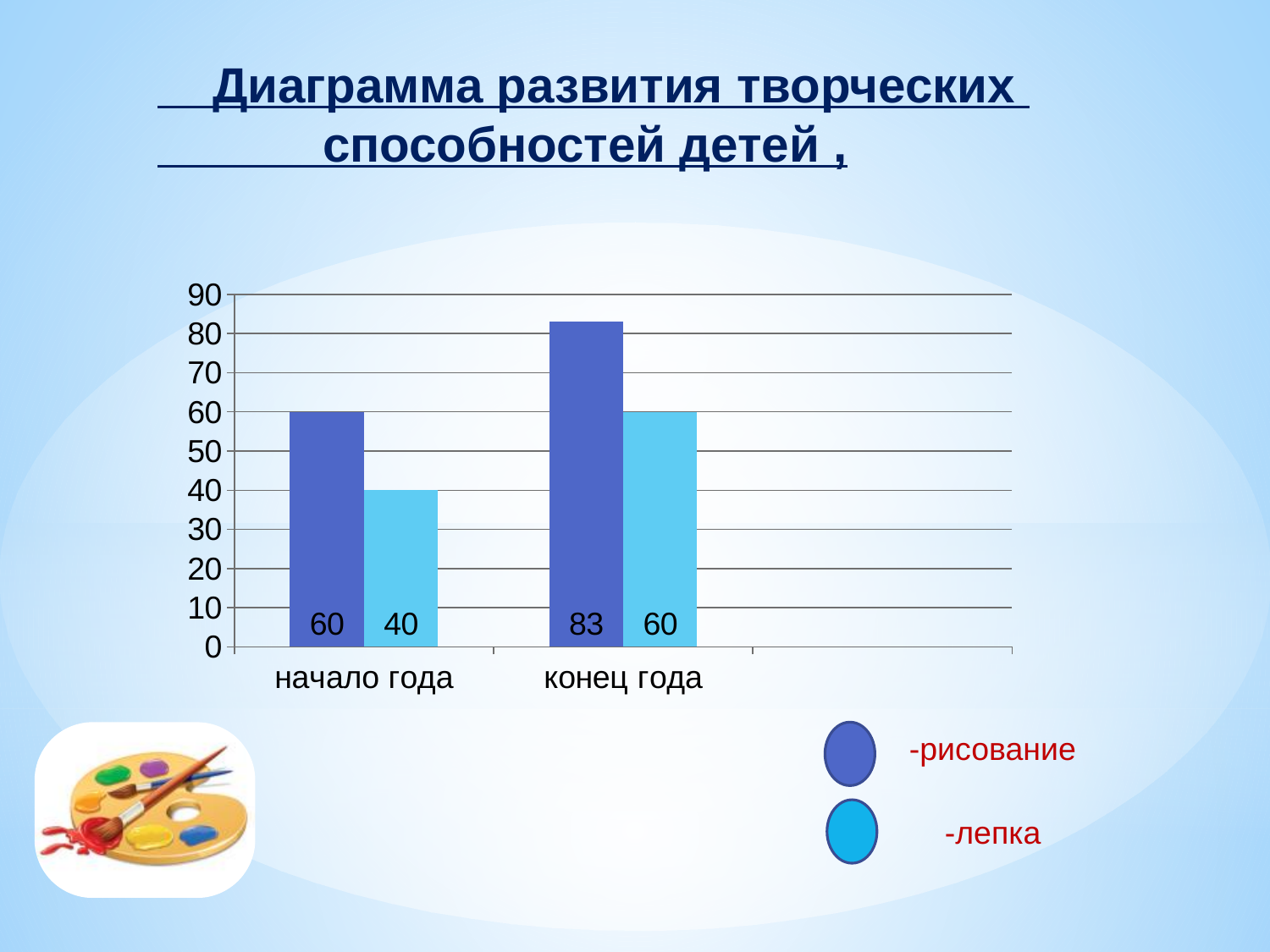
What is the value for лепка at конец года? 60 How many categories are shown on the x axis? 2 Which bar has the lowest value on the chart? лепка, начало года What is the value for лепка at начало года? 40 By how much did the value for лепка increase from начало года to конец года? 20 Which bar has the highest value on the chart? рисование, конец года What kind of chart is shown on the slide? bar chart What is the value for рисование at начало года? 60 How many series does the legend list? 2 Which is larger: рисование at начало года or лепка at начало года? рисование What is the difference between рисование and лепка at конец года? 23 What is the value for рисование at конец года? 83